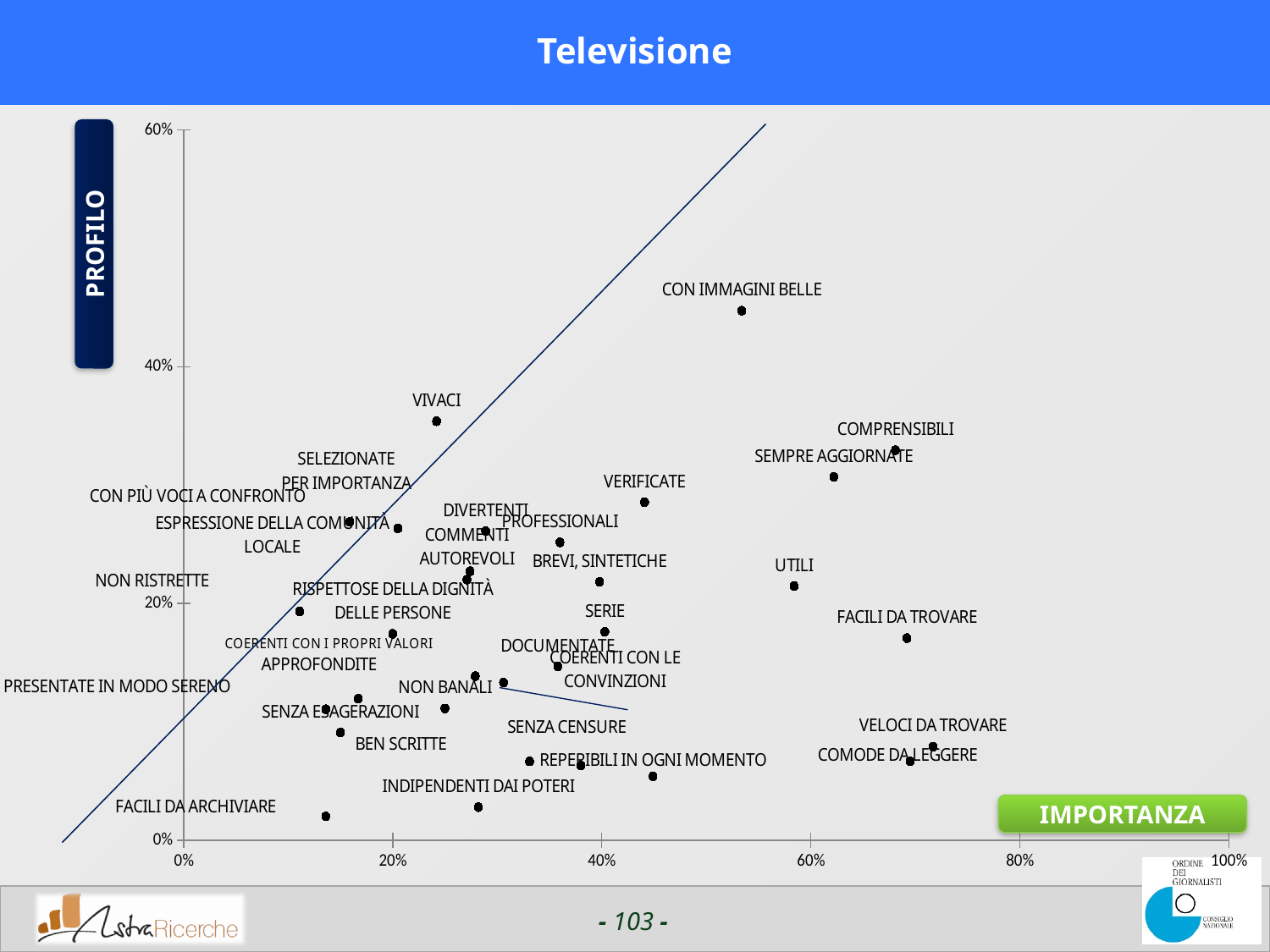
Which has the higher IMPORTANZA value, COMPRENSIBILI or VIVACI? COMPRENSIBILI Which point has the highest PROFILO value? CON IMMAGINI BELLE What is the label of the horizontal axis? IMPORTANZA What kind of chart is shown on the slide? scatter chart Is the IMPORTANZA value for UTILI greater or less than 40%? greater Which point has the lowest PROFILO value? FACILI DA ARCHIVIARE Which has the higher PROFILO value, VERIFICATE or SERIE? VERIFICATE Is the PROFILO value for COMPRENSIBILI greater or less than 40%? less Is the PROFILO value for VIVACI greater or less than 20%? greater What is the title of the slide? Televisione